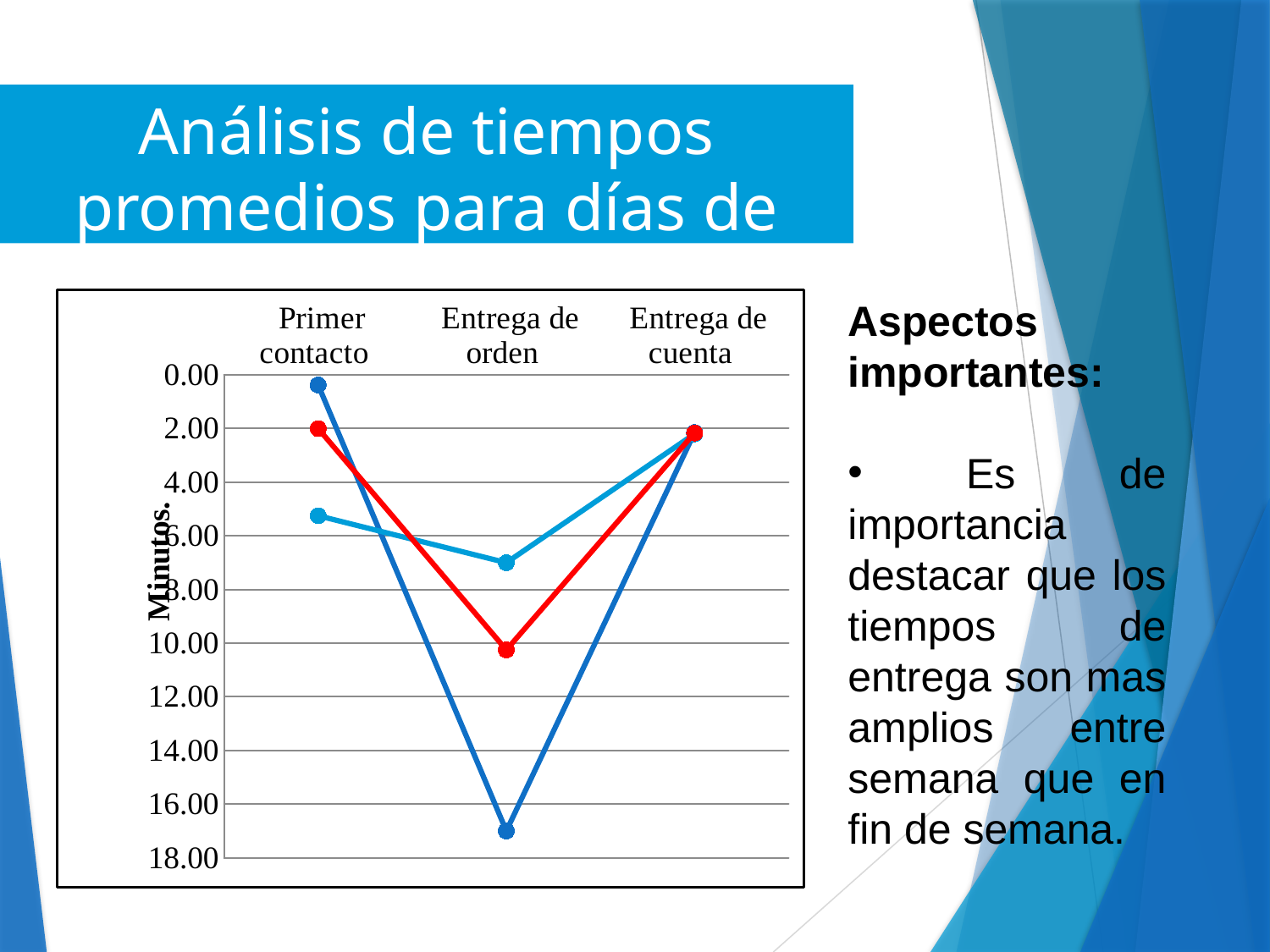
Is the value of the dark blue line at Primer contacto greater or less than 2.00? less Is the value of the light blue line at Primer contacto greater or less than 4.00? greater For the dark blue line, which category has the highest value? Entrega de orden How many lines are plotted in the chart? 3 Is the value of the dark blue line at Entrega de orden greater or less than 16.00? greater At Entrega de orden, which line has the highest value? the dark blue line At Primer contacto, which is larger: the value of the light blue line or the value of the dark blue line? the light blue line What is the label of the vertical axis of the chart? Minutos. How many categories are shown on the x axis of the chart? 3 What kind of chart is shown on the slide? line chart